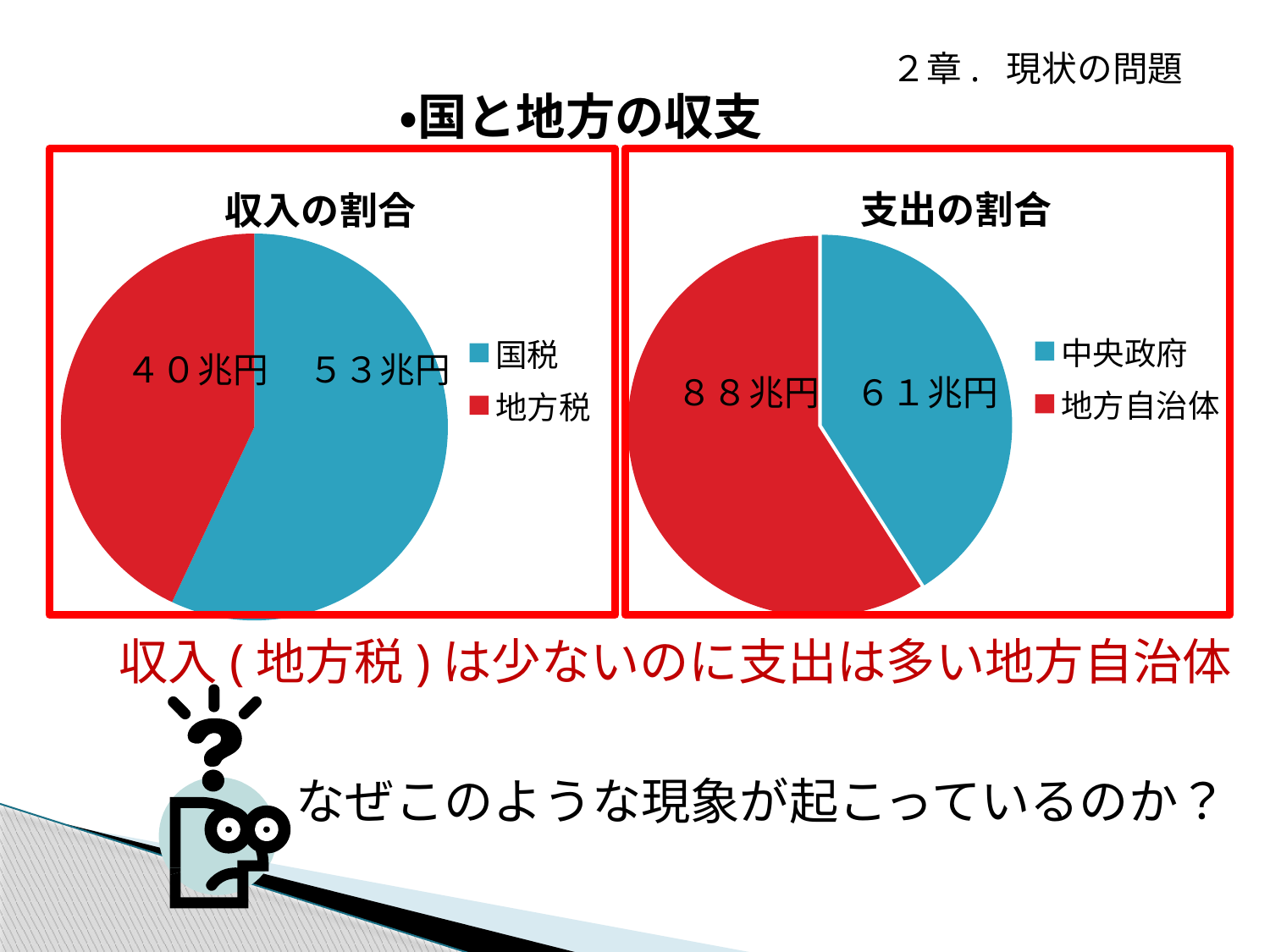
In the 収入の割合 chart, which category has the larger value? 国税 What type of chart is the 収入の割合 chart? pie chart How many categories does the legend of the 支出の割合 chart list? 2 In the 収入の割合 chart, what is the value for 地方税? ４０兆円 In the 支出の割合 chart, what is the value for 中央政府? ６１兆円 In the 収入の割合 chart, what is the value for 国税? ５３兆円 In the 支出の割合 chart, is the value for 地方自治体 larger or smaller than the value for 中央政府? larger In the 支出の割合 chart, which colour represents 地方自治体? red In the 収入の割合 chart, what is the difference between 国税 and 地方税? １３兆円 In the 支出の割合 chart, what is the difference between 地方自治体 and 中央政府? ２７兆円 In the 支出の割合 chart, which category has the smaller value? 中央政府 In the 支出の割合 chart, what is the value for 地方自治体? ８８兆円